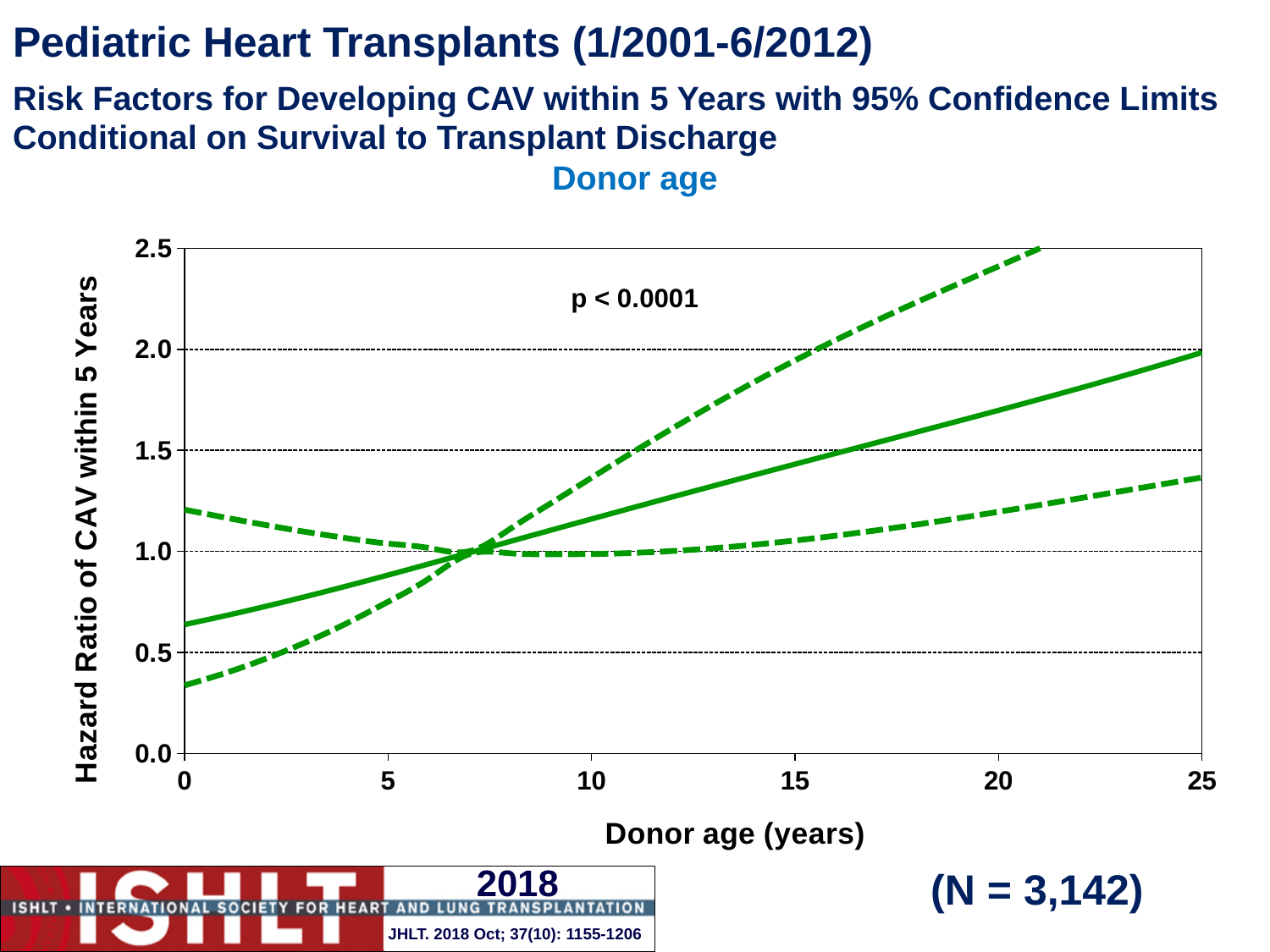
What p-value is printed on the chart? p < 0.0001 Is the value of the lower dashed confidence limit at donor age 25 greater or less than 1.5? less Is the value of the solid hazard ratio line at donor age 0 greater or less than 1.0? less Is the value of the solid hazard ratio line at donor age 15 greater or less than 1.0? greater What kind of chart is shown on the slide? line chart Does the solid line (hazard ratio) rise or fall as donor age increases? rises What is the label of the y-axis? Hazard Ratio of CAV within 5 Years How many lines are plotted on the chart? 3